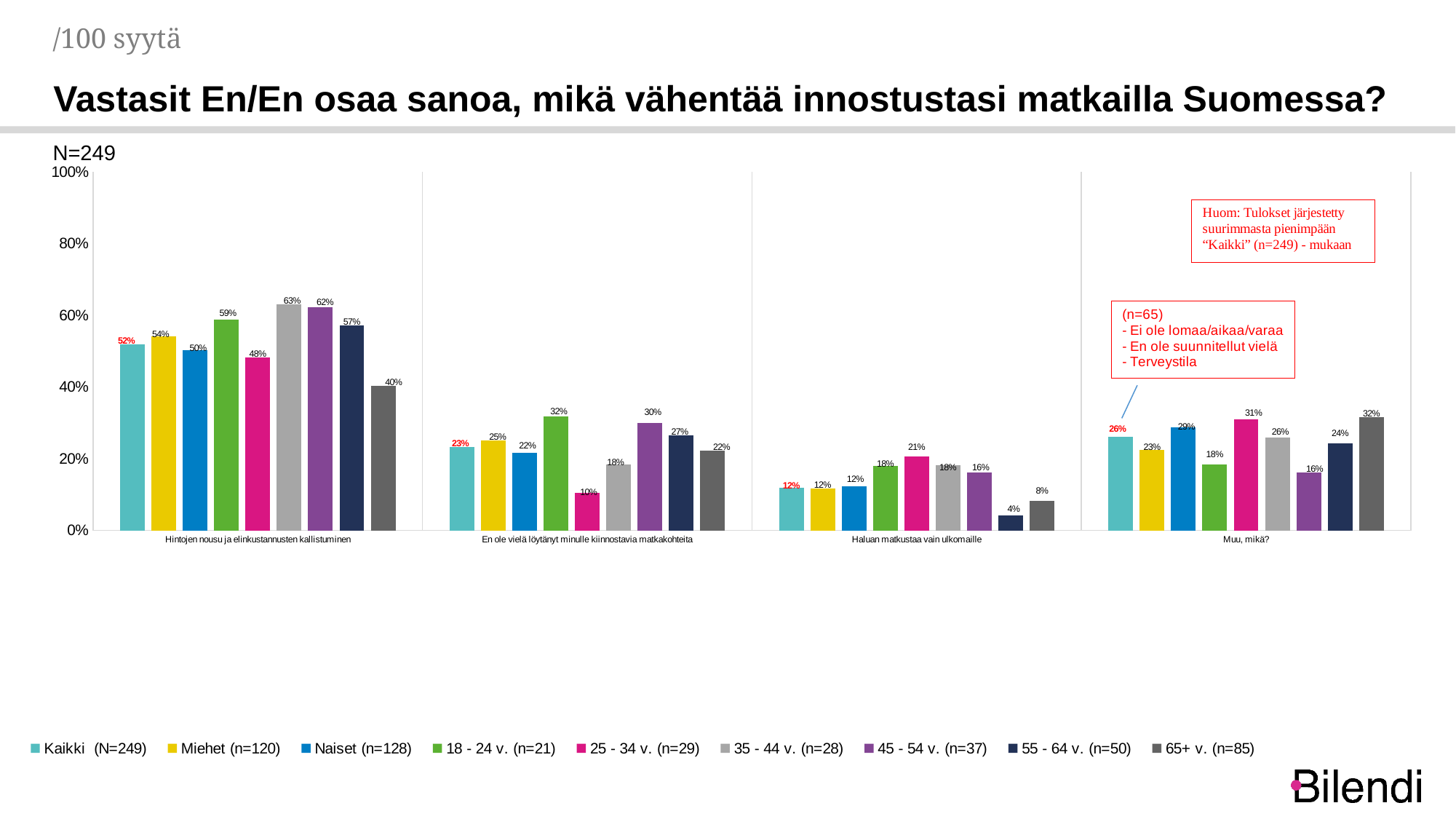
How many categories are shown on the x axis? 4 Which series has the highest value in the category 'Muu, mikä?'? 65+ v. (n=85) What is the difference between the Miehet (n=120) and Naiset (n=128) values in the category 'Hintojen nousu ja elinkustannusten kallistuminen'? 4% In the category 'En ole vielä löytänyt minulle kiinnostavia matkakohteita', which is larger: the value for 18 - 24 v. (n=21) or the value for 45 - 54 v. (n=37)? 18 - 24 v. (n=21) What is the N value stated above the chart? N=249 What is the value for 35 - 44 v. (n=28) in the category 'Hintojen nousu ja elinkustannusten kallistuminen'? 63% What kind of chart is shown on the slide? bar chart How many series does the legend list? 9 What is the value for 55 - 64 v. (n=50) in the category 'Haluan matkustaa vain ulkomaille'? 4% What is the value for 25 - 34 v. (n=29) in the category 'En ole vielä löytänyt minulle kiinnostavia matkakohteita'? 10% What is the value for Kaikki (N=249) in the category 'Hintojen nousu ja elinkustannusten kallistuminen'? 52% Which series has the lowest value in the category 'Hintojen nousu ja elinkustannusten kallistuminen'? 65+ v. (n=85)